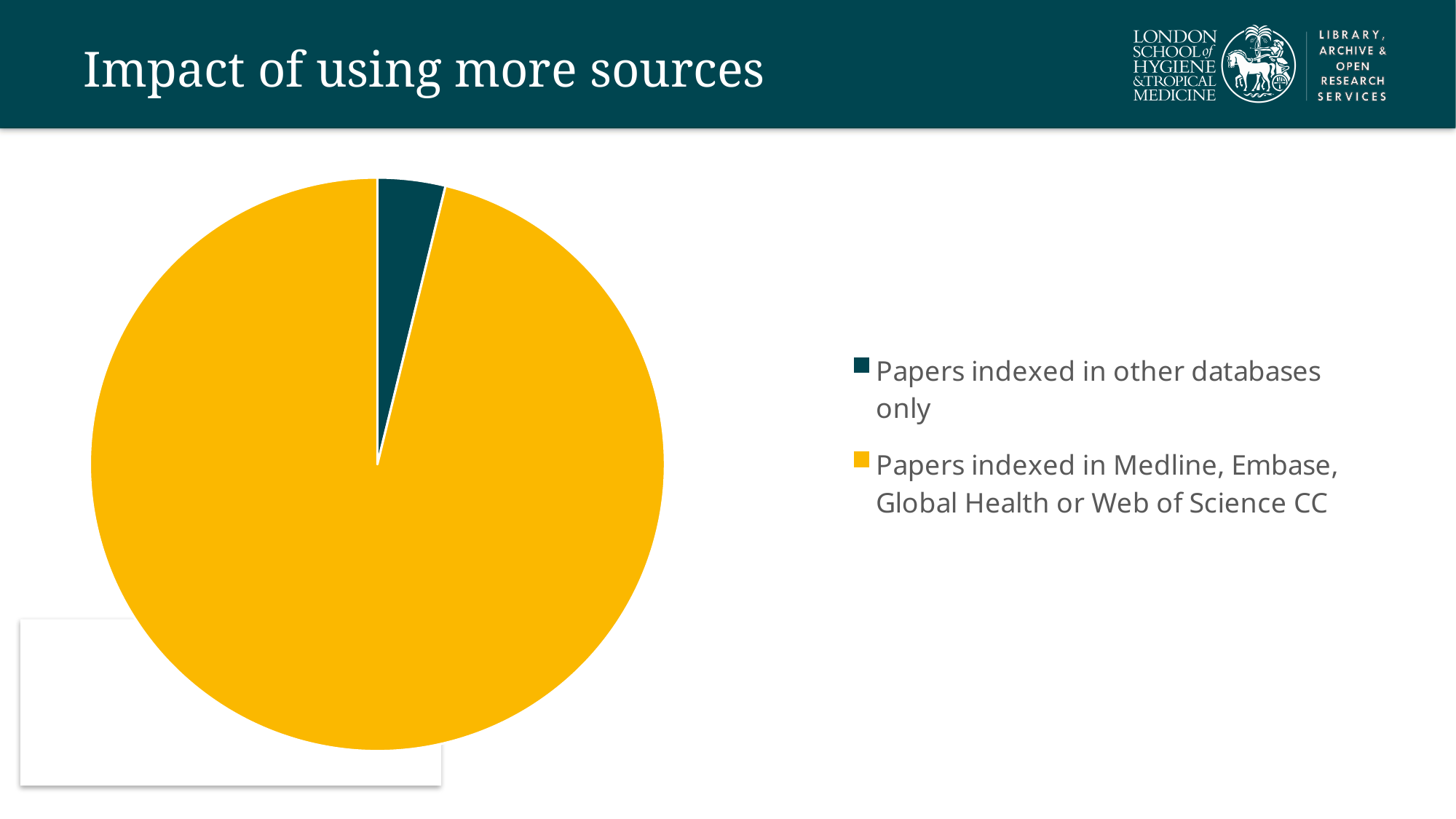
How many entries does the legend of the pie chart list? 2 Which category takes up the smallest share of the pie chart? Papers indexed in other databases only What kind of chart is shown on the slide? Pie chart What colour is the slice for papers indexed in other databases only? Dark teal Which category takes up the largest share of the pie chart? Papers indexed in Medline, Embase, Global Health or Web of Science CC What is the title of the slide containing the pie chart? Impact of using more sources Which is larger in the pie chart: the slice for papers indexed in other databases only, or the slice for papers indexed in Medline, Embase, Global Health or Web of Science CC? Papers indexed in Medline, Embase, Global Health or Web of Science CC How many slices does the pie chart have? 2